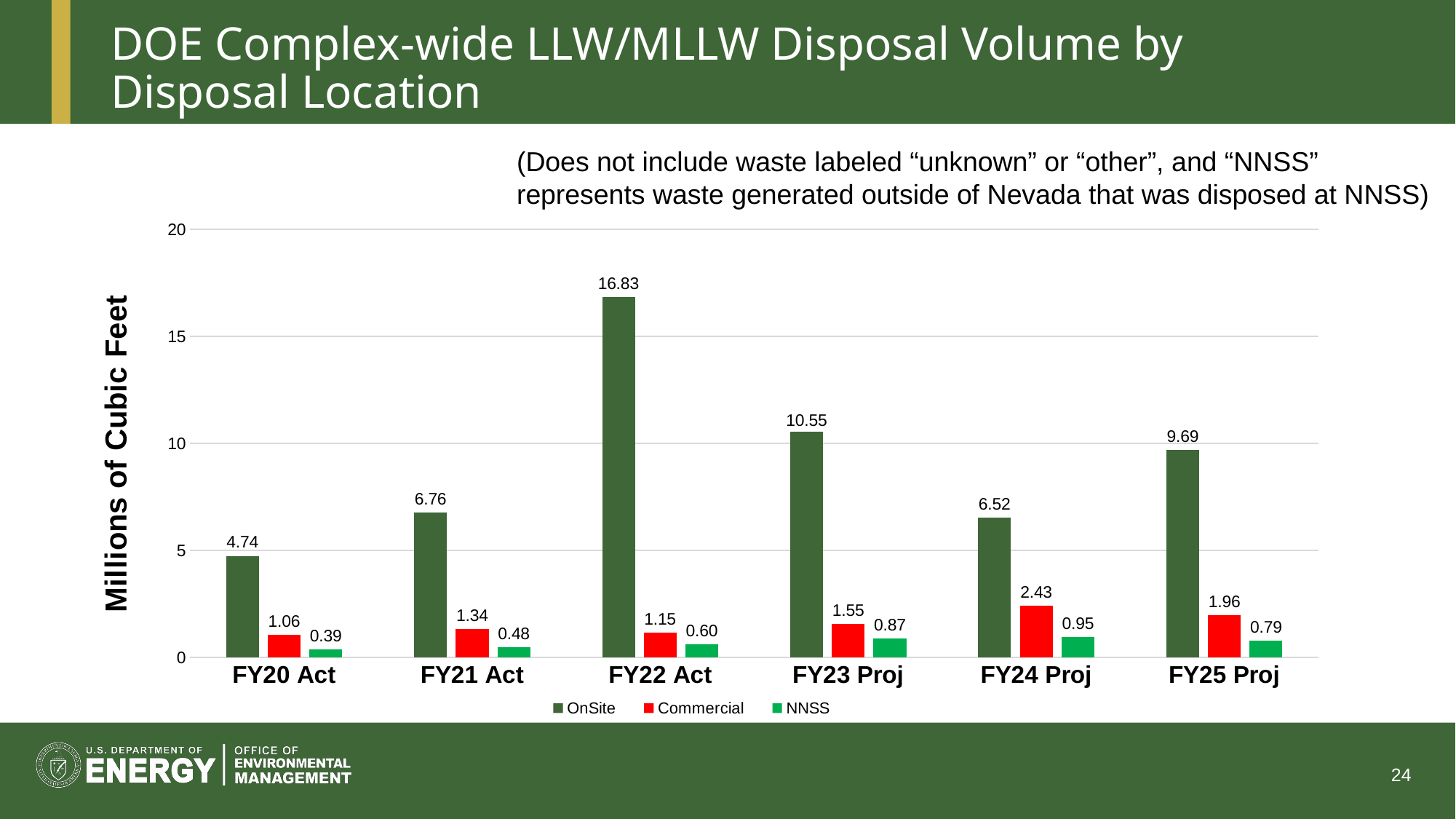
How many series does the legend list? 3 Which fiscal year has the lowest NNSS disposal volume? FY20 Act Is the OnSite value for FY25 Proj greater or less than 10? less What is the OnSite disposal volume for FY22 Act? 16.83 What is the NNSS disposal volume for FY20 Act? 0.39 What is the label on the y axis? Millions of Cubic Feet How many fiscal year categories are shown on the x axis? 6 What is the difference between the OnSite volumes for FY23 Proj and FY24 Proj? 4.03 Which fiscal year has the highest OnSite disposal volume? FY22 Act Which is larger, the Commercial volume for FY21 Act or for FY22 Act? FY21 Act What kind of chart is shown on the slide? Bar chart What is the Commercial disposal volume for FY24 Proj? 2.43